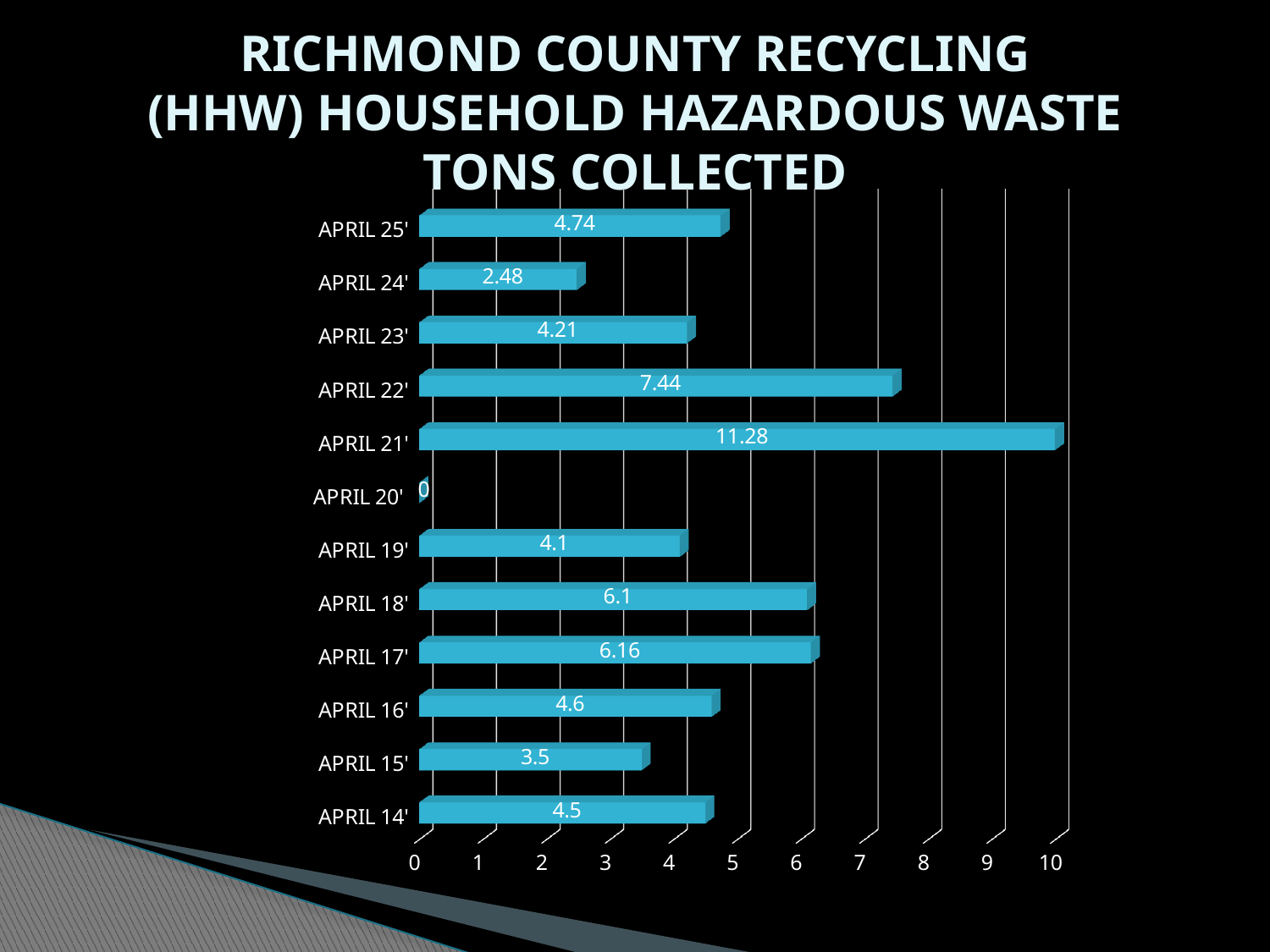
Is the value for APRIL 21' greater or less than 10? greater What value is shown for APRIL 21'? 11.28 What value is shown for APRIL 24'? 2.48 What is the difference between the values for APRIL 25' and APRIL 14'? 0.24 What is the title of the chart? RICHMOND COUNTY RECYCLING (HHW) HOUSEHOLD HAZARDOUS WASTE TONS COLLECTED Which is larger, the value for APRIL 18' or the value for APRIL 16'? APRIL 18' Which category has the lowest value? APRIL 20' What is the difference between the values for APRIL 22' and APRIL 23'? 3.23 What value is shown for APRIL 17'? 6.16 Which category has the highest value? APRIL 21' What kind of chart is this? bar chart How many categories are shown on the chart? 12